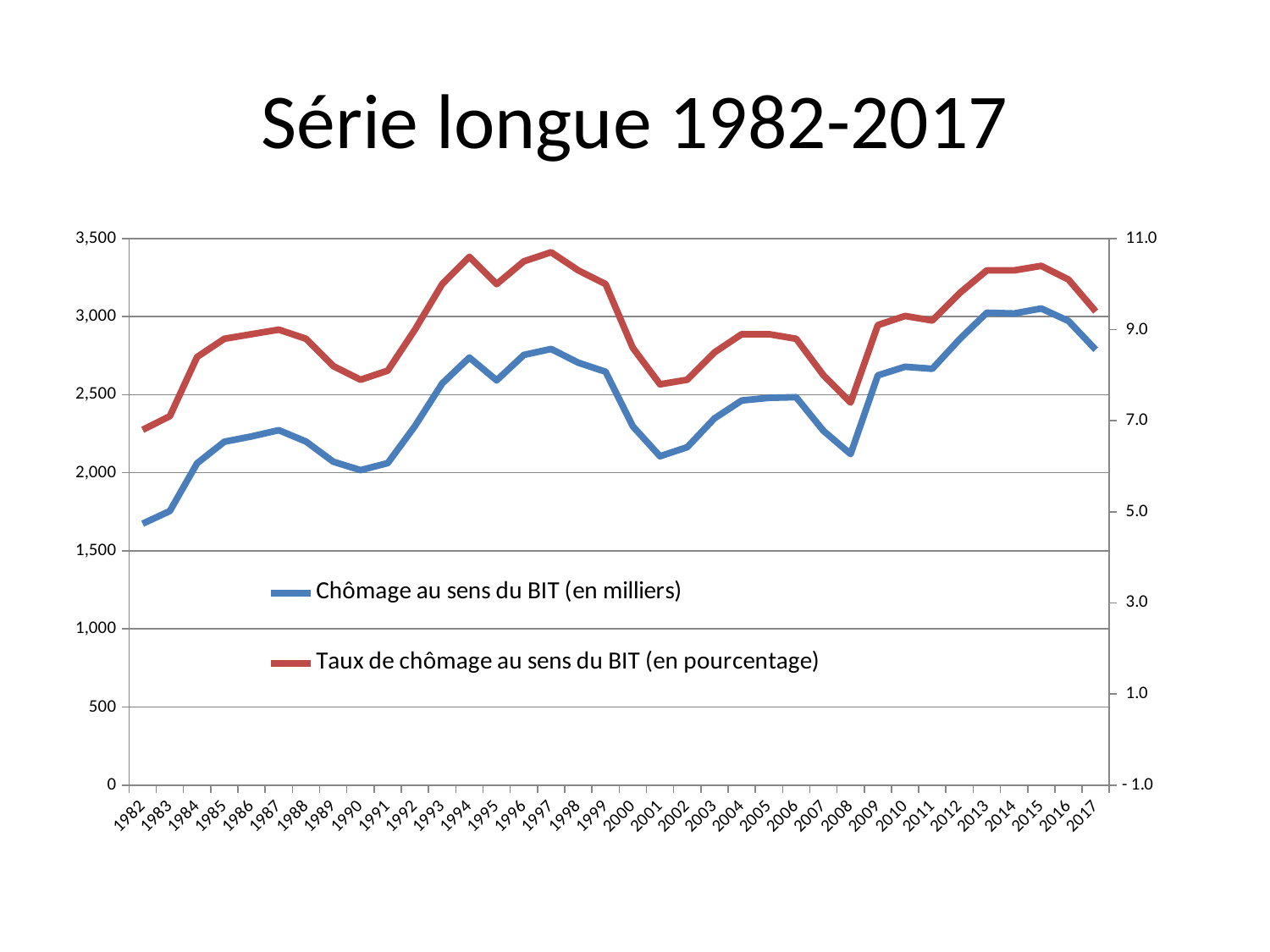
Does the value of 'Chômage au sens du BIT (en milliers)' rise or fall from 2008 to 2013? rise Which series is drawn in red? Taux de chômage au sens du BIT (en pourcentage) How many series does the legend list? 2 In which year is the value of 'Chômage au sens du BIT (en milliers)' lowest? 1982 What is the title of the chart? Série longue 1982-2017 Is the value for 'Taux de chômage au sens du BIT (en pourcentage)' in 2008 greater or less than 9.0? less In which year is the value of 'Taux de chômage au sens du BIT (en pourcentage)' lowest? 1982 What kind of chart is shown on the slide? line chart Is the value for 'Taux de chômage au sens du BIT (en pourcentage)' in 1997 greater or less than 9.0? greater How many years are plotted along the x axis? 36 Is the value for 'Chômage au sens du BIT (en milliers)' in 2015 greater or less than 3,000? greater